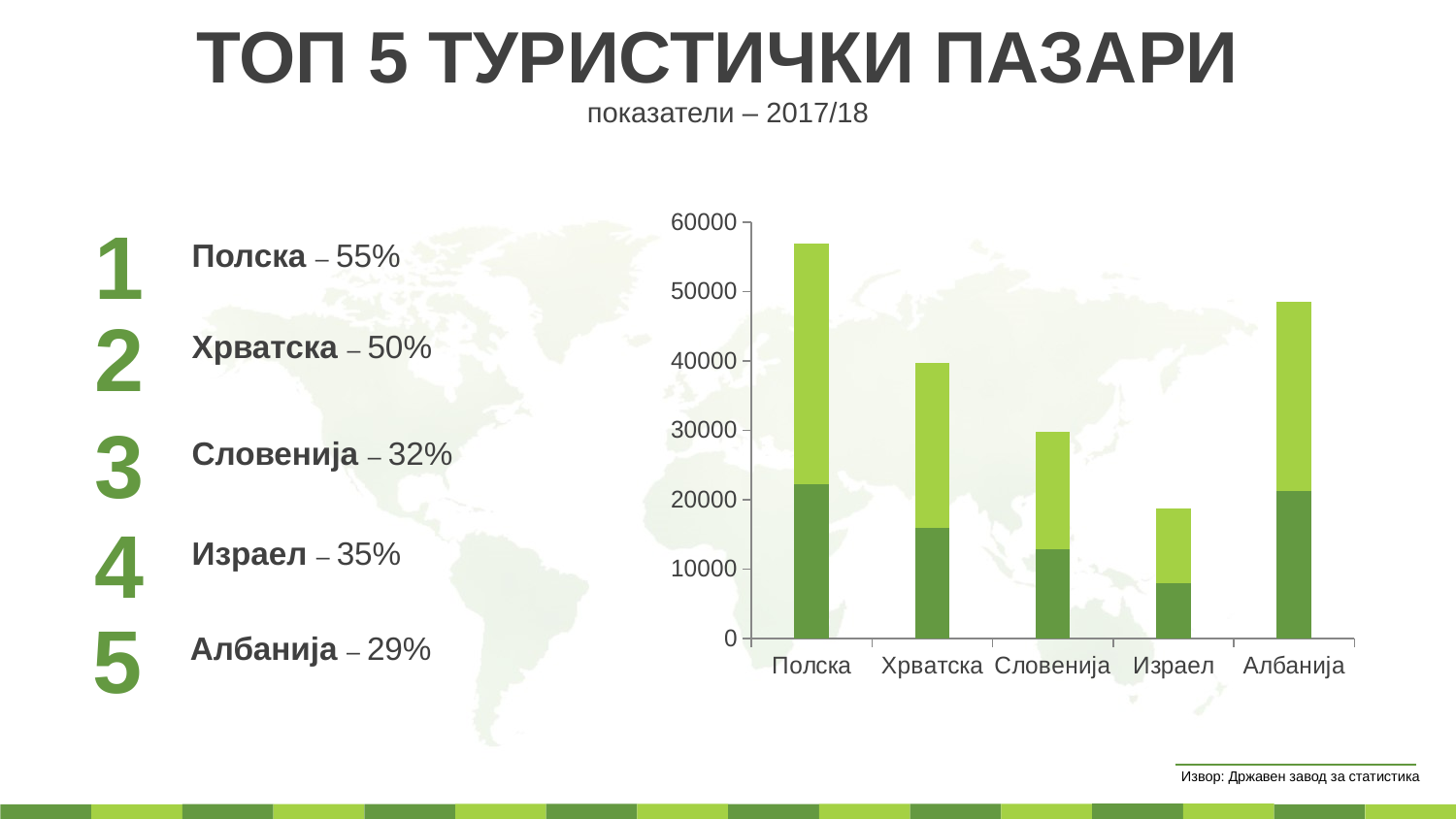
Is the total value for Словенија greater or less than 20000? greater Which country is listed first on the x axis of the chart? Полска Which bar is taller, Словенија or Израел? Словенија Which country has the shortest bar in the chart? Израел Which bar is taller, Албанија or Хрватска? Албанија Is the total value for Израел greater or less than 20000? less Is the total value for Полска greater or less than 50000? greater What is the highest value shown on the y axis of the chart? 60000 What kind of chart is shown on the slide? stacked bar chart How many countries are shown on the x axis of the chart? 5 Which country has the tallest bar in the chart? Полска